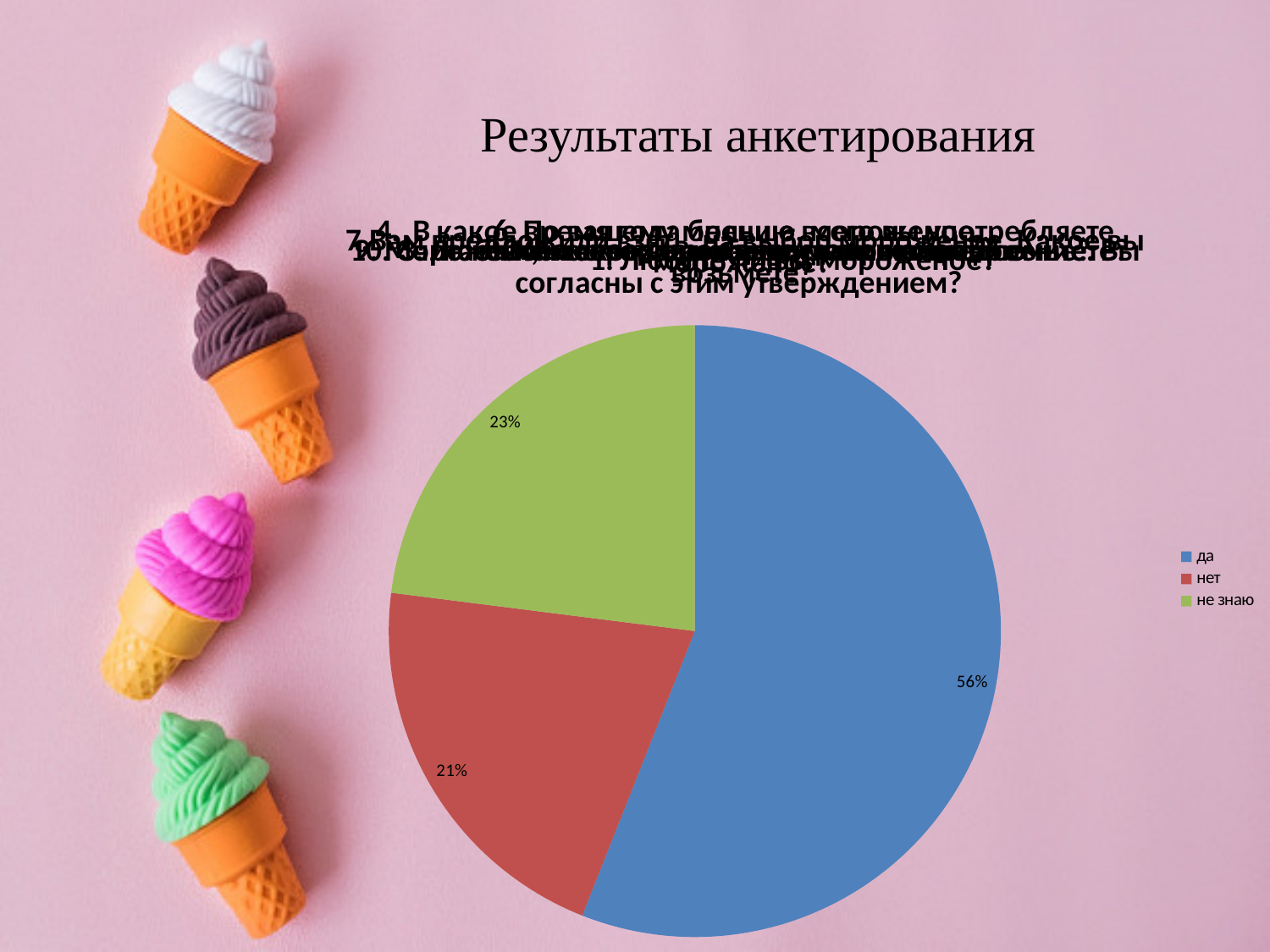
What kind of chart is shown on the slide? pie chart What share of the pie does the "нет" slice represent? 21% Which answer option has the largest share of the pie? да What is the difference in percentage points between the "да" and "нет" slices? 35 What share of the pie does the "не знаю" slice represent? 23% How many entries does the legend list? 3 What colour is the "не знаю" slice in the pie chart? green Which answer option has the smallest share of the pie? нет What share of the pie does the "да" slice represent? 56% Which slice is larger, "да" or "не знаю"? да How many slices does the pie chart have? 3 What is the difference in percentage points between the "не знаю" and "нет" slices? 2